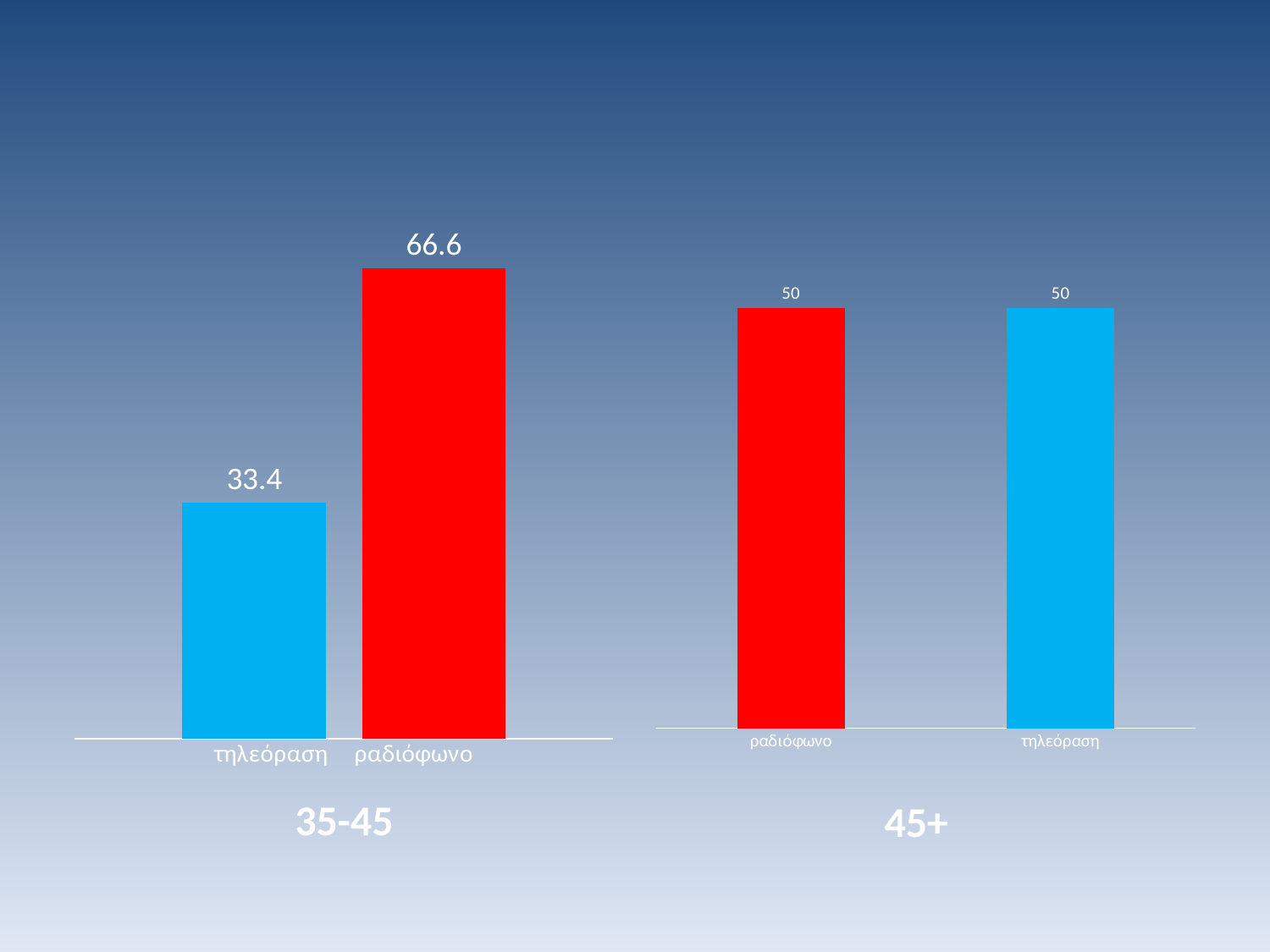
In the 35-45 chart, what is the value for ραδιόφωνο? 66.6 In the 35-45 chart, what is the difference between the values for ραδιόφωνο and τηλεόραση? 33.2 How many categories does the 35-45 chart show? 2 What kind of chart is the 45+ chart? bar chart In the 45+ chart, what is the value for ραδιόφωνο? 50 In the 45+ chart, what is the difference between the values for ραδιόφωνο and τηλεόραση? 0 In the 35-45 chart, which category has the lowest value? τηλεόραση In the 45+ chart, what colour is the bar for ραδιόφωνο? red In the 35-45 chart, which is larger, the value for τηλεόραση or the value for ραδιόφωνο? ραδιόφωνο In the 45+ chart, what is the value for τηλεόραση? 50 In the 35-45 chart, what is the value for τηλεόραση? 33.4 In the 35-45 chart, which category has the highest value? ραδιόφωνο